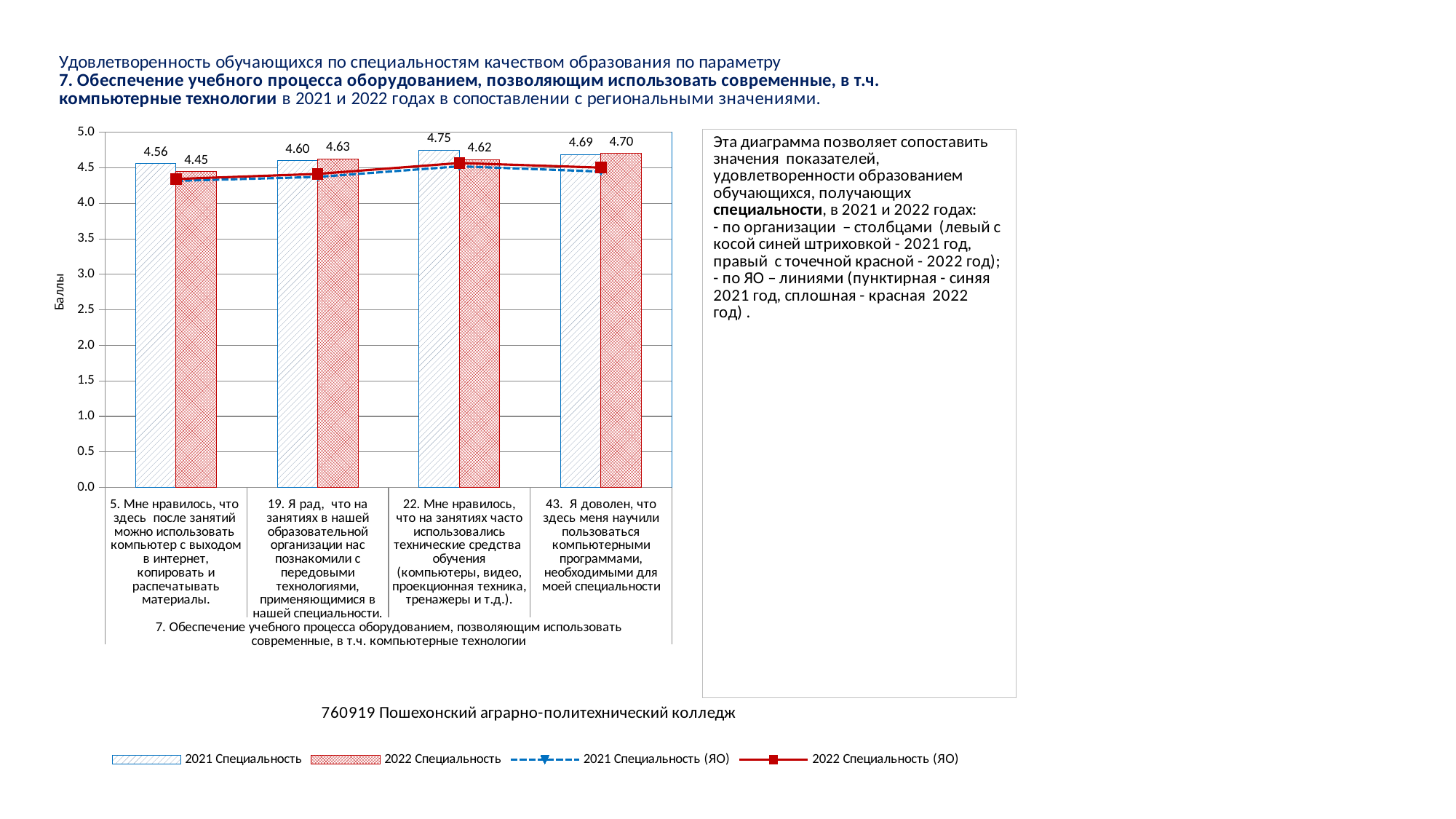
What is the value of the 2022 Специальность bar for category "43. Я доволен, что здесь меня научили пользоваться компьютерными программами"? 4.70 How many categories are shown on the x axis of the chart? 4 How many series does the chart legend list? 4 Is the value of the 2022 Специальность (ЯО) line for category "5. Мне нравилось, что здесь после занятий можно использовать компьютер с выходом в интернет" greater or less than 4.5? less What is the title of the vertical axis of the chart? Баллы What is the value of the 2021 Специальность bar for category "22. Мне нравилось, что на занятиях часто использовались технические средства обучения"? 4.75 What is the difference between the 2021 and 2022 Специальность values for category "22. Мне нравилось, что на занятиях часто использовались технические средства обучения"? 0.13 What kind of chart is shown on the slide? Bar chart with line series Which category has the lowest 2022 Специальность value? 5. Мне нравилось, что здесь после занятий можно использовать компьютер с выходом в интернет What is the value of the 2022 Специальность bar for category "5. Мне нравилось, что здесь после занятий можно использовать компьютер с выходом в интернет"? 4.45 Which category has the highest 2021 Специальность value? 22. Мне нравилось, что на занятиях часто использовались технические средства обучения For category "5. Мне нравилось, что здесь после занятий можно использовать компьютер с выходом в интернет", which is larger: the 2021 Специальность value or the 2022 Специальность value? 2021 Специальность